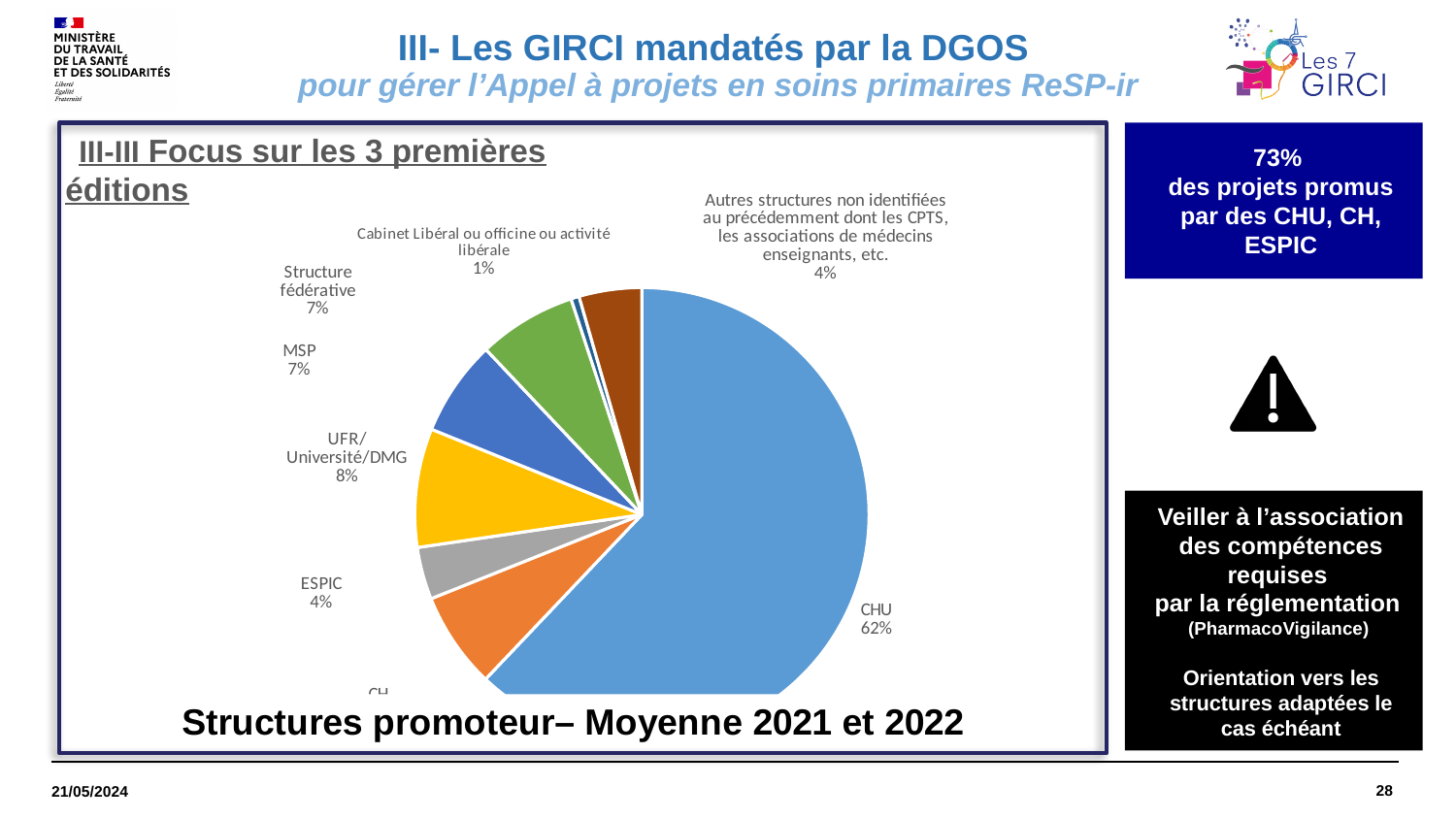
What share of the pie does CHU represent? 62% What is the value shown for Structure fédérative? 7% Which category has the largest slice of the pie? CHU What is the value shown for MSP? 7% What is the title printed below the pie chart? Structures promoteur– Moyenne 2021 et 2022 What kind of chart is shown on the slide? pie chart What is the difference in percentage points between CHU and UFR/Université/DMG? 54 Which is larger, the share for MSP or the share for ESPIC? MSP What is the value shown for ESPIC? 4% What is the value shown for UFR/Université/DMG? 8% Which category has the smallest slice of the pie? Cabinet Libéral ou officine ou activité libérale What is the value shown for Cabinet Libéral ou officine ou activité libérale? 1%